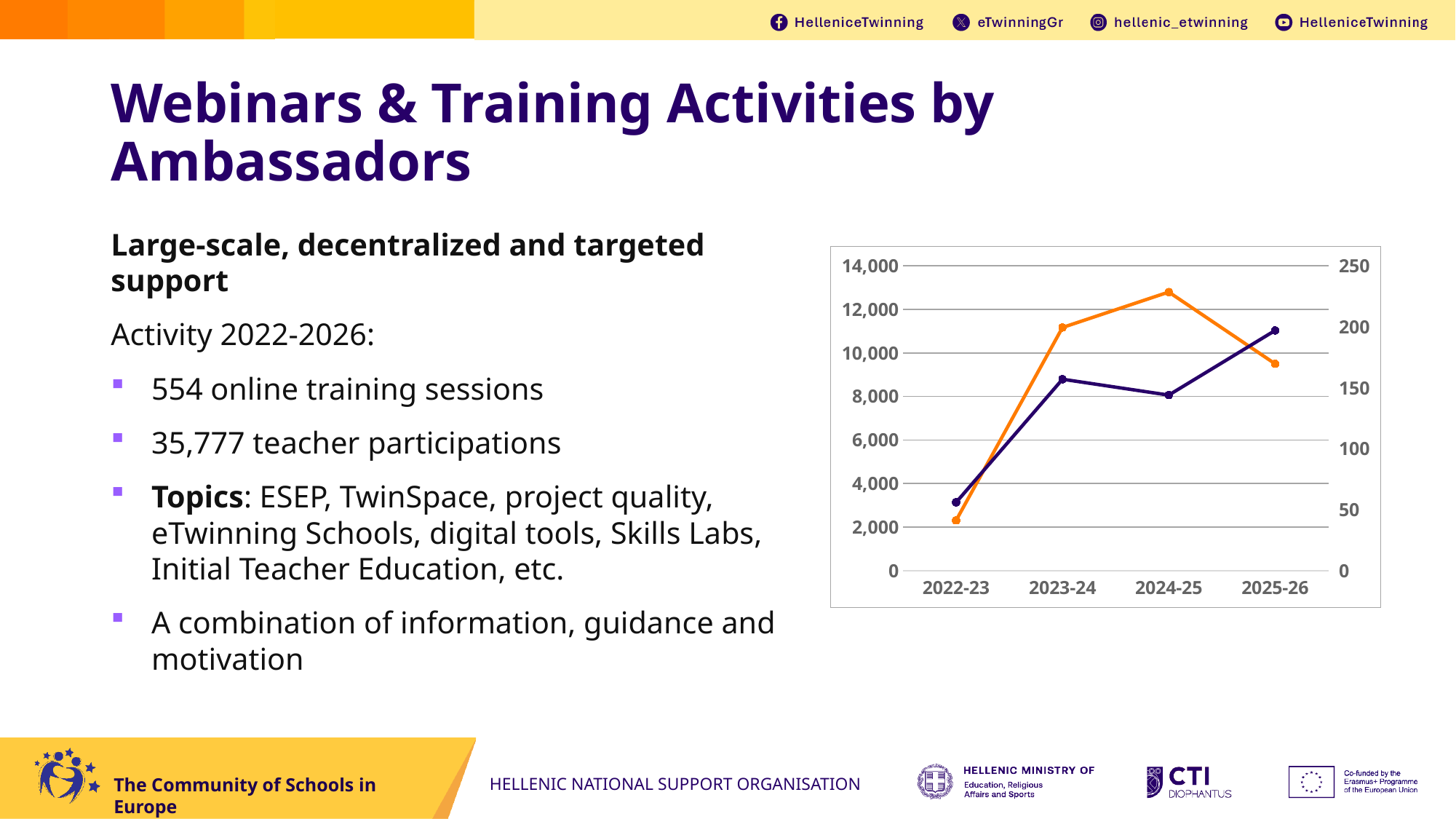
Reading against the left axis, is the dark purple line's value for 2022-23 greater or less than 4,000? less In which period does the dark purple line reach its highest point? 2025-26 In which period does the dark purple line have its lowest point? 2022-23 At 2025-26, which line is plotted higher on the chart, the orange line or the dark purple line? dark purple line How many lines are plotted on the chart? 2 At 2023-24, which line is plotted higher on the chart, the orange line or the dark purple line? orange line What kind of chart is shown on the slide? line chart In which period does the orange line reach its highest point? 2024-25 Reading against the left axis, is the orange line's value for 2024-25 greater or less than 12,000? greater In which period does the orange line have its lowest point? 2022-23 How many time periods are shown on the x axis of the chart? 4 Does the orange line rise or fall between 2024-25 and 2025-26? fall